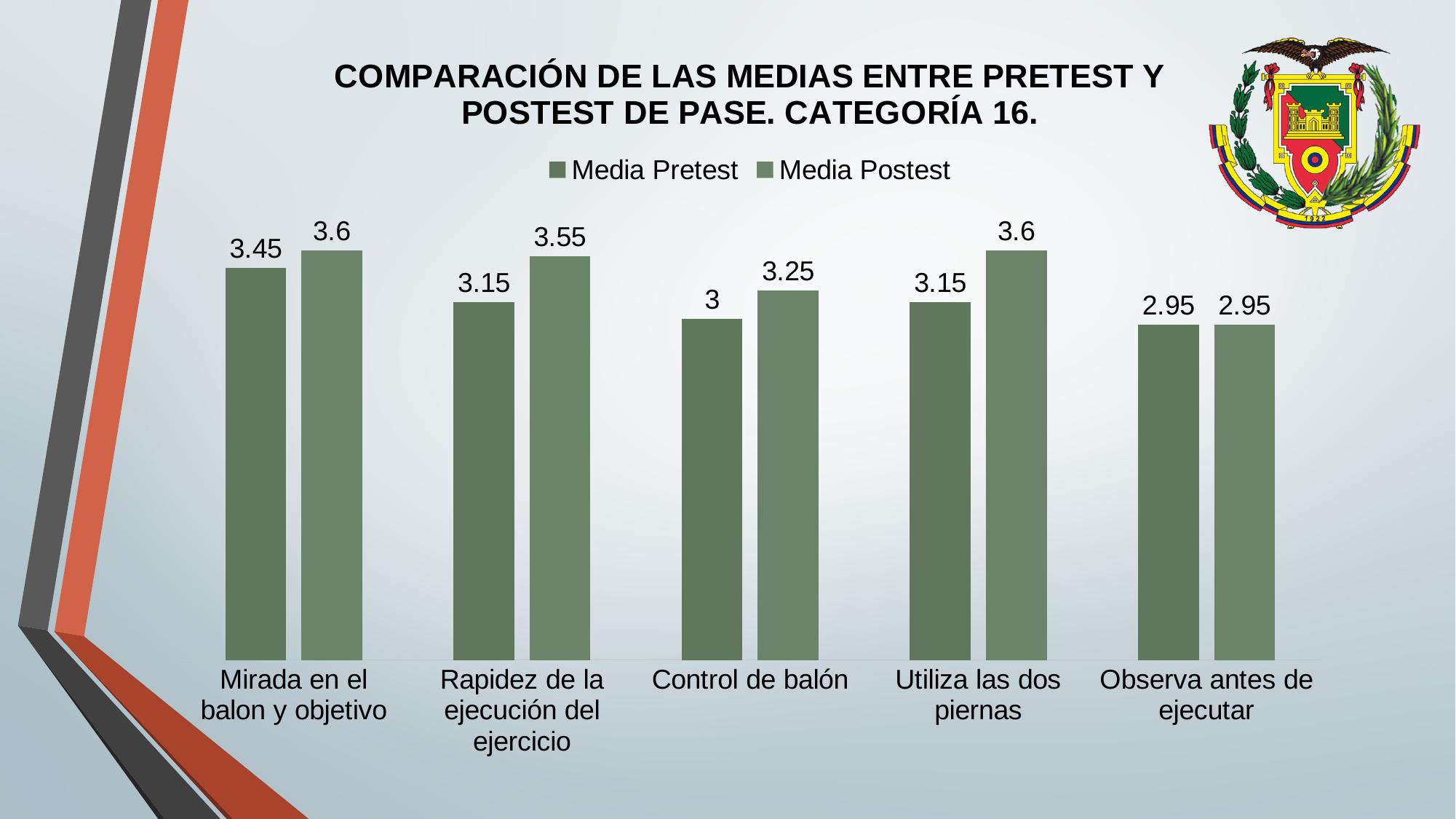
What is the Media Postest value for Rapidez de la ejecución del ejercicio? 3.55 What is the difference between the Media Postest and Media Pretest values for Utiliza las dos piernas? 0.45 How many categories are shown on the x axis? 5 What kind of chart is shown on the slide? Bar chart Which is larger for Rapidez de la ejecución del ejercicio, Media Pretest or Media Postest? Media Postest What is the Media Postest value for Observa antes de ejecutar? 2.95 What are the two series named in the legend? Media Pretest and Media Postest What is the difference between the Media Postest and Media Pretest values for Control de balón? 0.25 Which category has the lowest Media Pretest value? Observa antes de ejecutar Which category has the highest Media Pretest value? Mirada en el balon y objetivo How many series does the legend list? 2 What is the Media Pretest value for Control de balón? 3